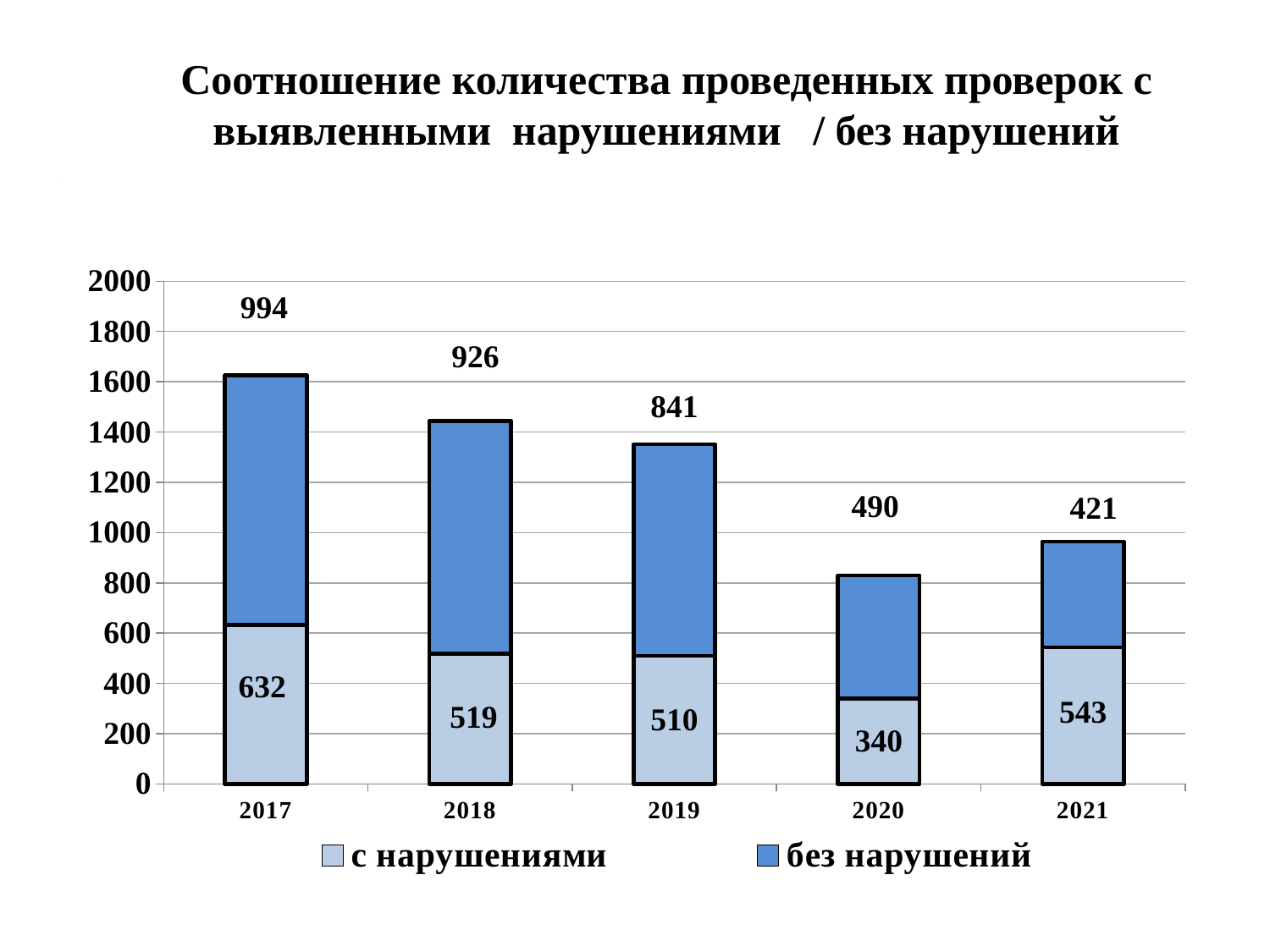
What is the difference between the 'без нарушений' values for 2018 and 2019? 85 How many years are shown on the x axis? 5 What is the total of the stacked bar for 2020? 830 Which is larger in 2021: 'с нарушениями' or 'без нарушений'? с нарушениями What is the value for 'с нарушениями' in 2021? 543 What is the value for 'без нарушений' in 2020? 490 What type of chart is shown on the slide? stacked bar chart What is the value for 'с нарушениями' in 2017? 632 Which year has the highest value for 'без нарушений'? 2017 Which year has the lowest value for 'с нарушениями'? 2020 Does the 'без нарушений' value fall or rise from 2017 to 2021? fall How many series does the legend list? 2